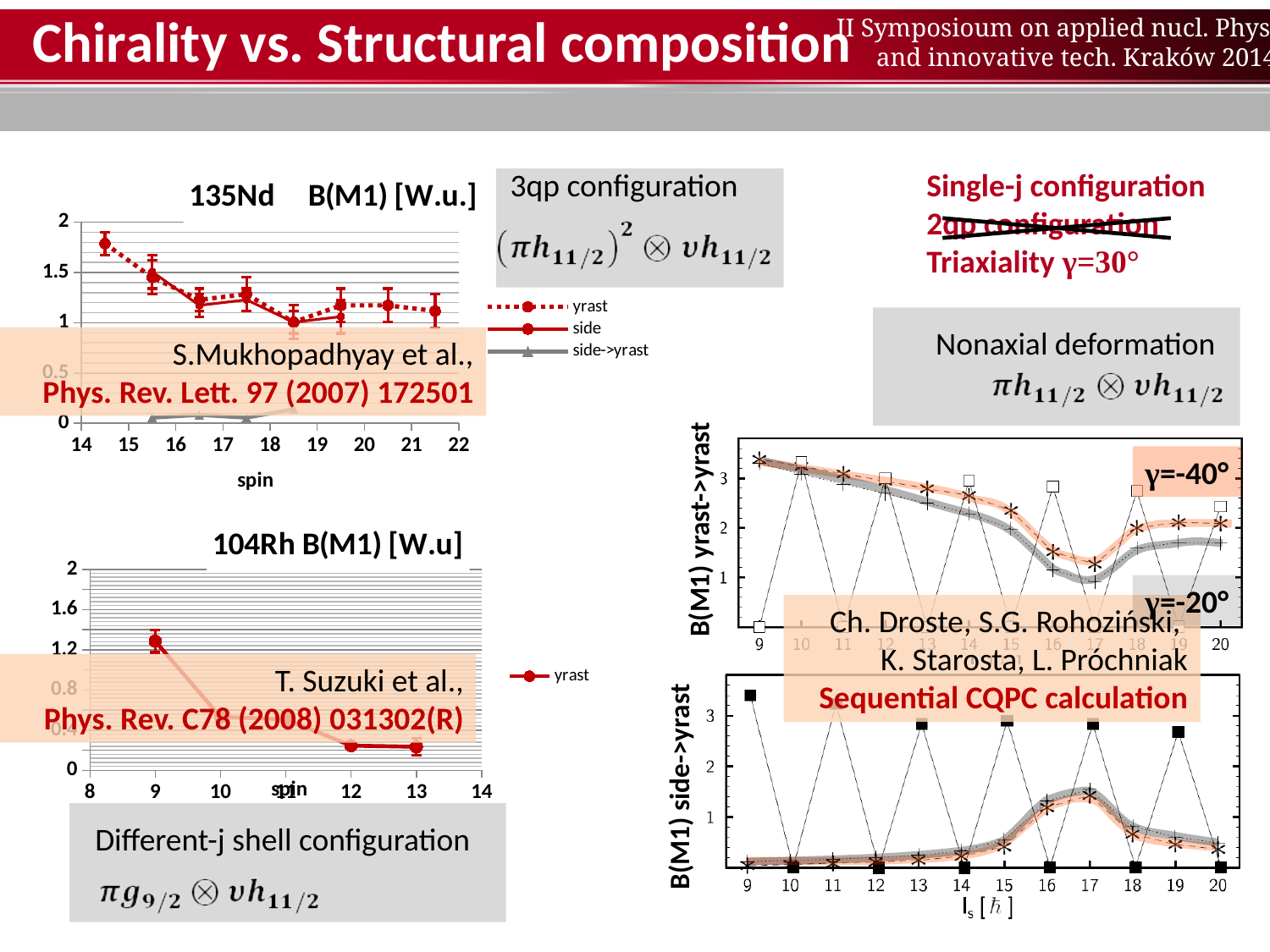
How many series does the legend of the 135Nd B(M1) [W.u.] chart list? 3 How many series does the legend of the 104Rh B(M1) [W.u] chart list? 1 In the 104Rh B(M1) [W.u] chart, is the yrast value at spin 12 greater or less than 0.4? less In the 104Rh B(M1) [W.u] chart, at which spin is the yrast value highest? 9 In the 104Rh B(M1) [W.u] chart, do the yrast values rise or fall as spin increases? fall What is the y-axis label of the upper chart on the right side of the slide? B(M1) yrast->yrast In the 135Nd B(M1) [W.u.] chart, which series is drawn with a dotted line? yrast In the 104Rh B(M1) [W.u] chart, which is larger: the yrast value at spin 9 or at spin 13? spin 9 In the 135Nd B(M1) [W.u.] chart, is the first (leftmost) yrast point greater or less than 1.5? greater In the 104Rh B(M1) [W.u] chart, is the yrast value at spin 9 greater or less than 1? greater In the 135Nd B(M1) [W.u.] chart, do the yrast values generally rise or fall as spin increases from 14 to 22? fall What kind of chart is the 135Nd B(M1) [W.u.] chart? line chart